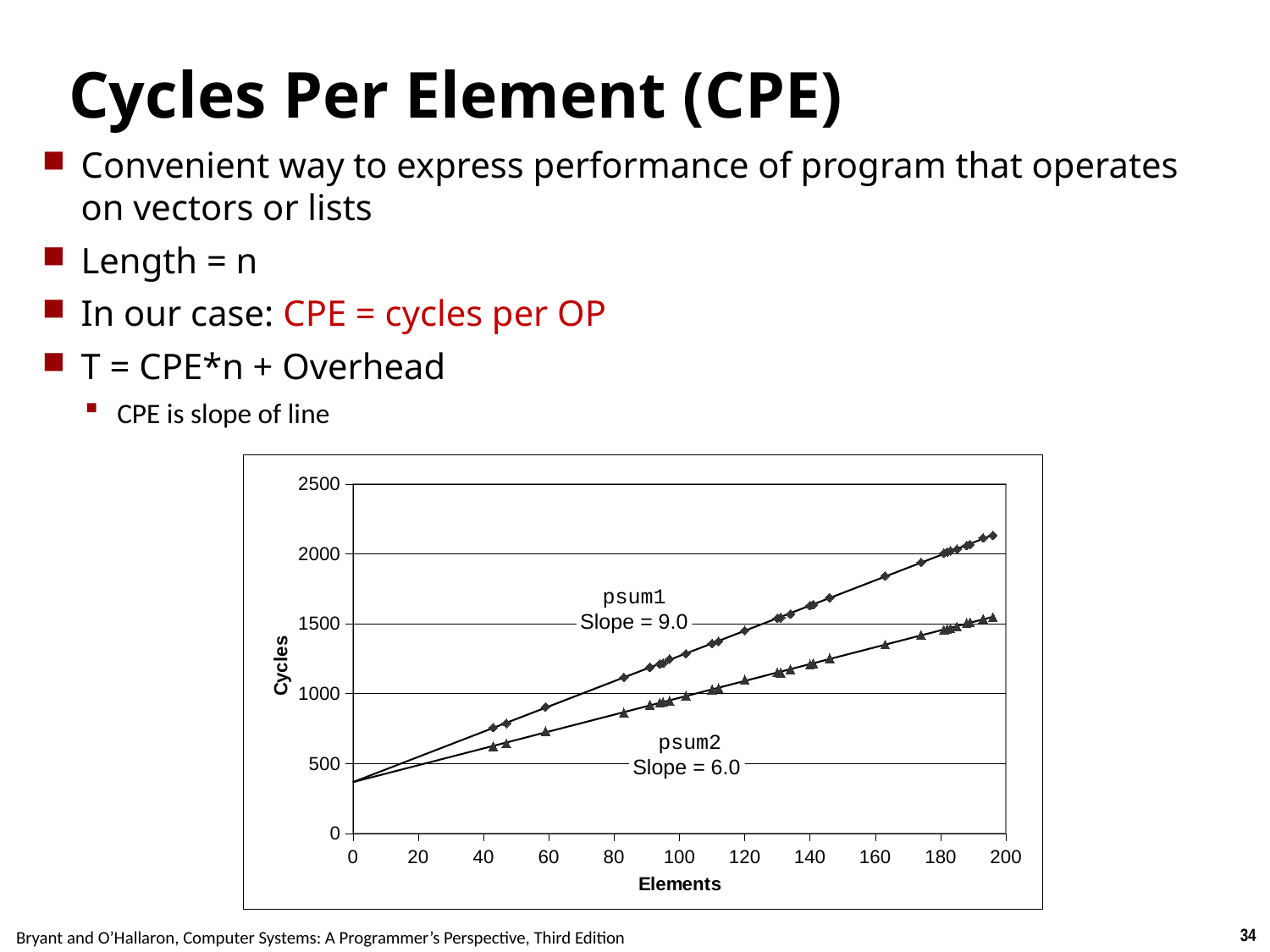
What slope is labelled for the psum2 series? 6.0 What is the title of the x axis of the chart? Elements What slope is labelled for the psum1 series? 9.0 Is the value for psum2 at about 195 elements greater or less than 2000 cycles? less Is the value for psum1 at about 195 elements greater or less than 2000 cycles? greater What is the highest value shown on the y axis of the chart? 2500 How many data series are plotted on the chart? 2 What is the title of the y axis of the chart? Cycles What kind of chart is shown on the slide? scatter chart with trend lines Do the cycle counts rise or fall as the number of elements increases? rise Which series has the steeper slope, psum1 or psum2? psum1